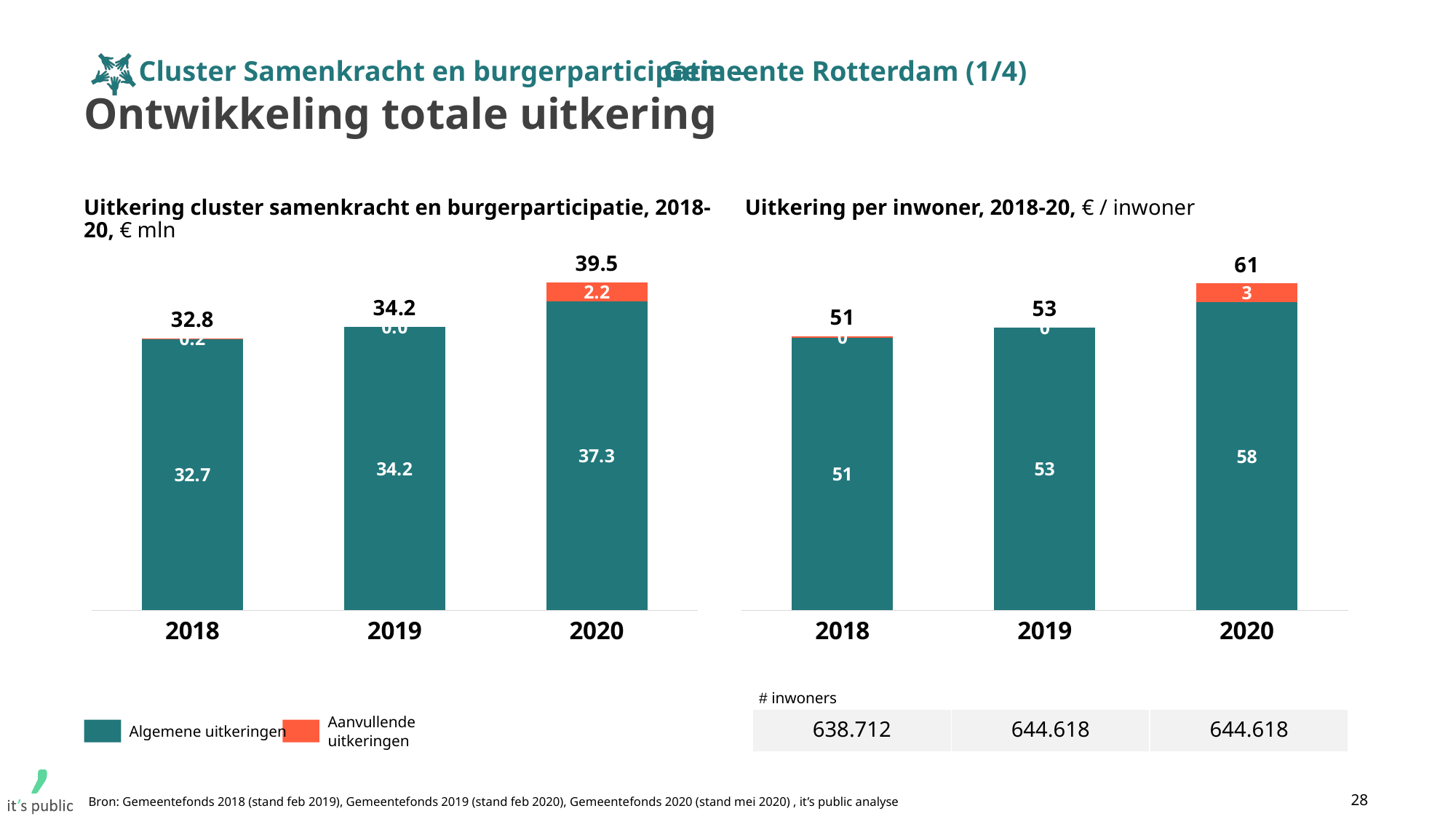
In the left chart, what is the difference between the total uitkering in 2020 and in 2018? 6.7 In the left chart (Uitkering cluster samenkracht en burgerparticipatie), what is the total uitkering for 2020? 39.5 In the right chart, which year has the lowest total uitkering per inwoner? 2018 In the left chart, which year has the highest total uitkering? 2020 In the left chart, what is the value of Aanvullende uitkeringen in 2020? 2.2 In the right chart, do the total values rise or fall from 2018 to 2020? rise What type of chart is the left chart? stacked bar chart How many series does the legend list for the left chart? 2 In the left chart, what is the value of Algemene uitkeringen in 2019? 34.2 In the right chart, what is the value of Algemene uitkeringen per inwoner in 2020? 58 In the right chart, what is the difference between the total uitkering per inwoner in 2020 and in 2019? 8 In the right chart (Uitkering per inwoner), what is the total uitkering per inwoner in 2020? 61